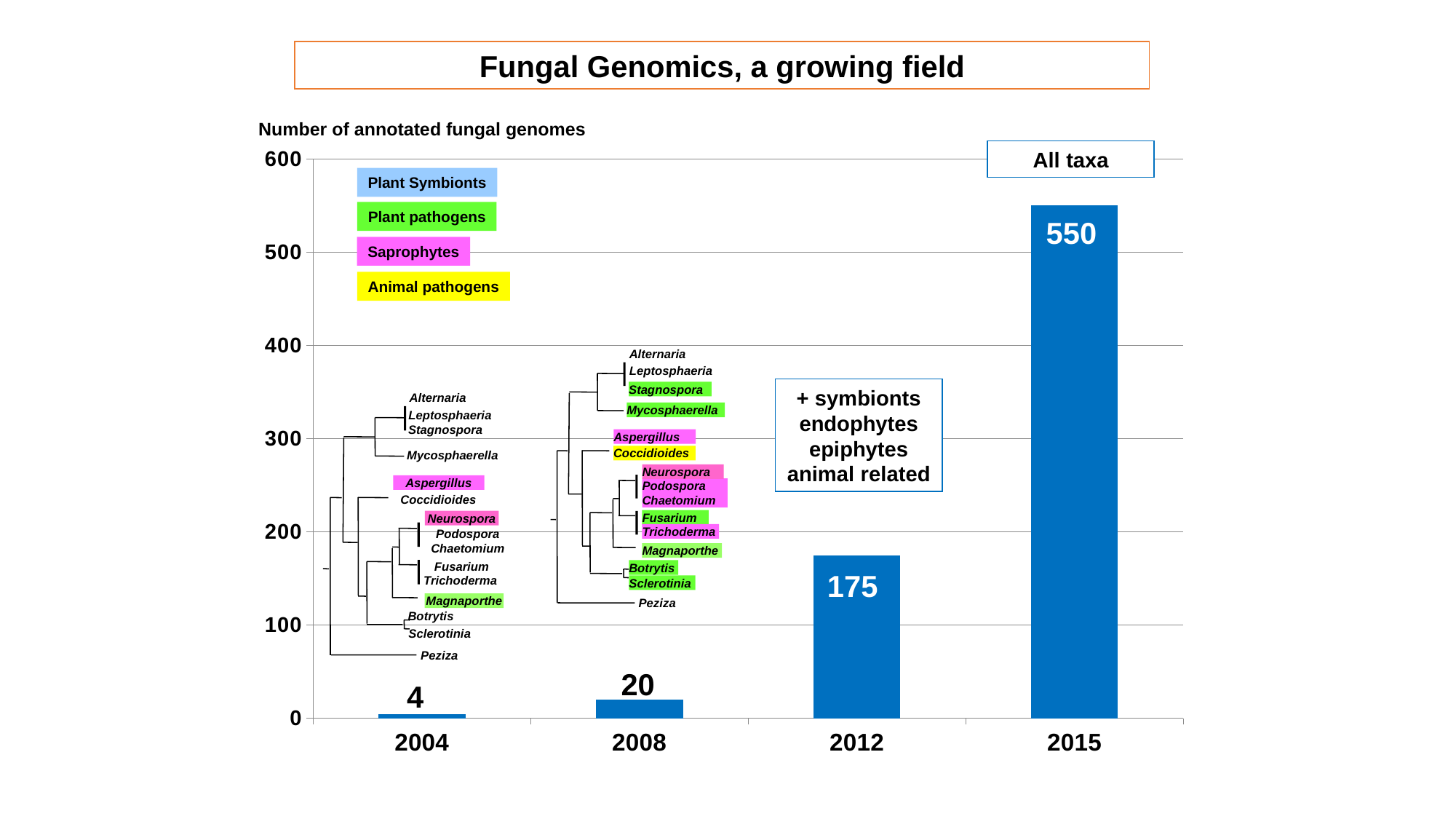
What is the number of annotated fungal genomes shown for 2012? 175 How many years are shown on the x axis of the chart? 4 What kind of chart is shown on the slide? bar chart What is the number of annotated fungal genomes shown for 2008? 20 Do the values rise or fall from 2004 to 2015? rise Which year has the highest number of annotated fungal genomes? 2015 Which year has a larger value, 2008 or 2012? 2012 What is the number of annotated fungal genomes shown for 2015? 550 Which year has the lowest number of annotated fungal genomes? 2004 What is the number of annotated fungal genomes shown for 2004? 4 What is the difference between the values for 2015 and 2012? 375 What is the difference between the values for 2012 and 2008? 155